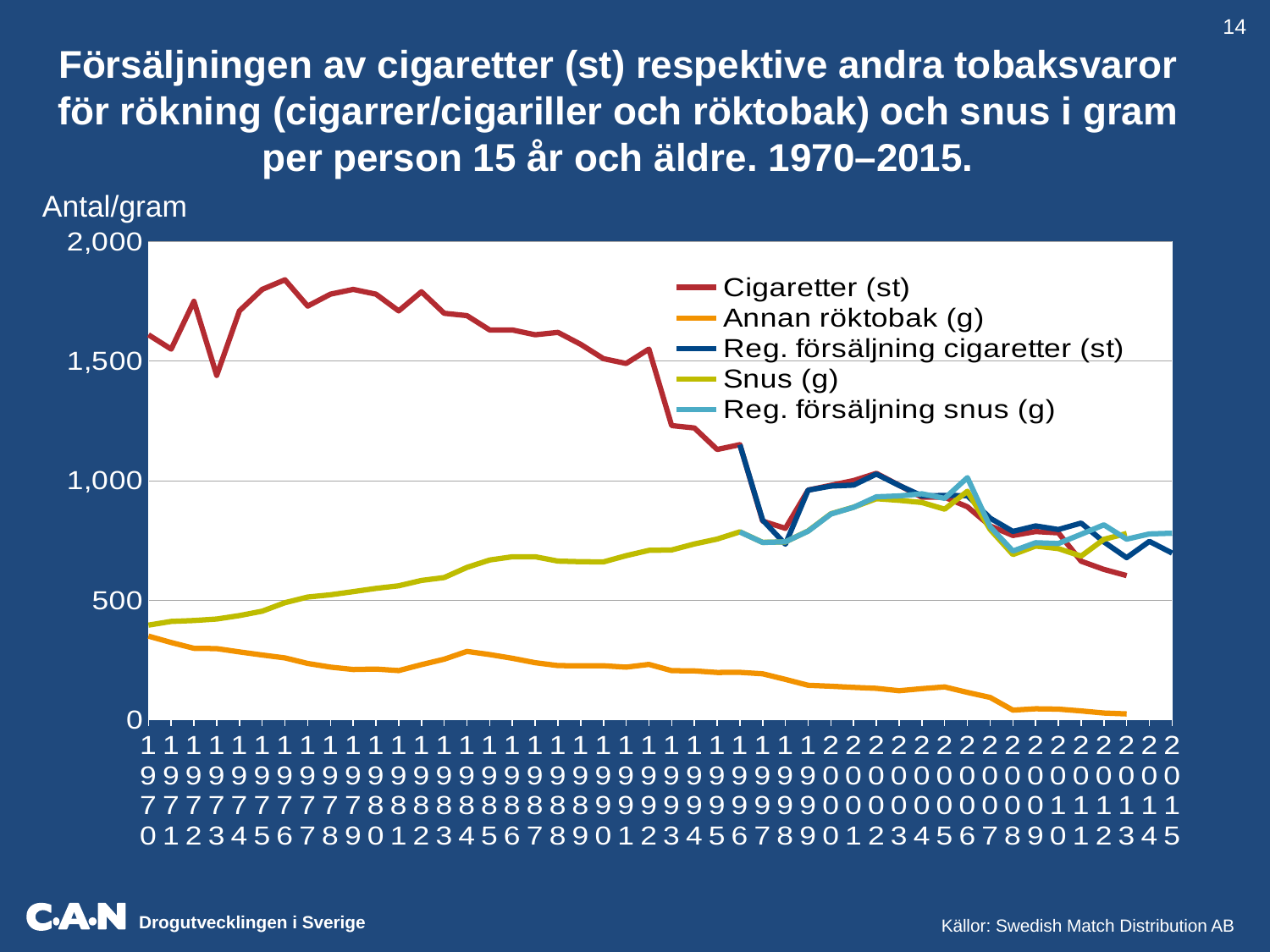
How many years are plotted along the x axis? 46 Is the value for Cigaretter (st) in 1970 greater or less than 1,500? greater What kind of chart is shown on the slide? Line chart In 1980, which is larger: Cigaretter (st) or Snus (g)? Cigaretter (st) How many series does the legend list? 5 Which series has the highest value in 1970? Cigaretter (st) What is the label shown on the vertical axis? Antal/gram Is the value for Snus (g) in 1970 greater or less than 500? less Does the Cigaretter (st) series rise or fall overall from 1970 to 2015? Fall Does the Annan röktobak (g) series rise or fall overall from 1970 to 2015? Fall Does the Snus (g) series rise or fall overall from 1970 to 2015? Rise